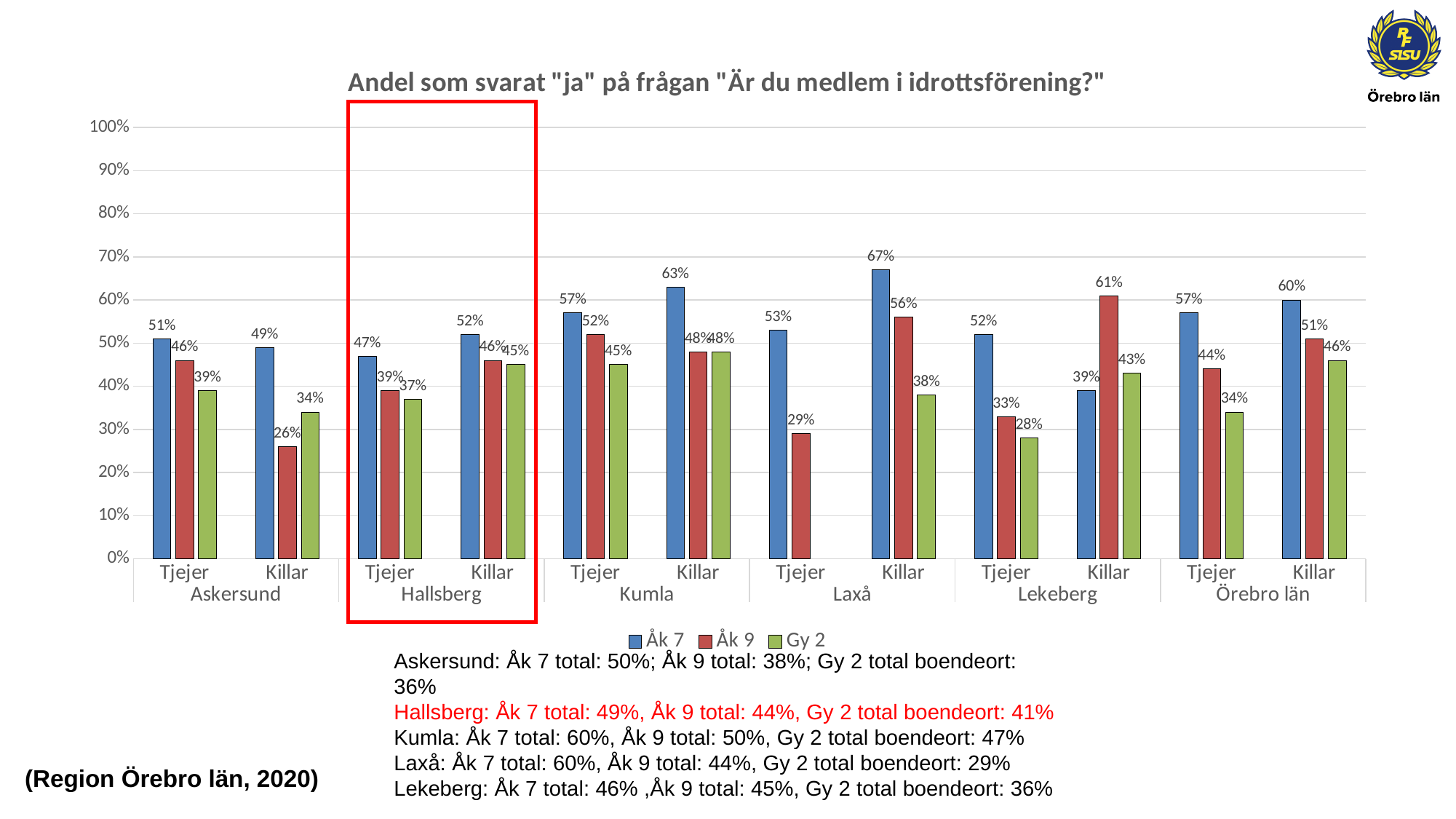
Is the Åk 9 value for Tjejer in Laxå greater or less than 30%? less What is the value for Gy 2 among Killar in Örebro län? 46% What is the title of the chart? Andel som svarat "ja" på frågan "Är du medlem i idrottsförening?" How many series does the legend list? 3 What is the value for Åk 7 among Killar in Laxå? 67% Which group and series has the lowest value in the chart? Killar in Askersund, Åk 9 How many municipalities (category groups) are shown on the x axis? 6 What is the difference between the Åk 7 value for Killar in Kumla and the Åk 7 value for Tjejer in Kumla? 6% What is the value for Åk 9 among Tjejer in Hallsberg? 39% What type of chart is shown on the slide? bar chart Which is larger for Killar in Lekeberg: the Åk 7 value or the Åk 9 value? Åk 9 Which group and series has the highest value in the chart? Killar in Laxå, Åk 7